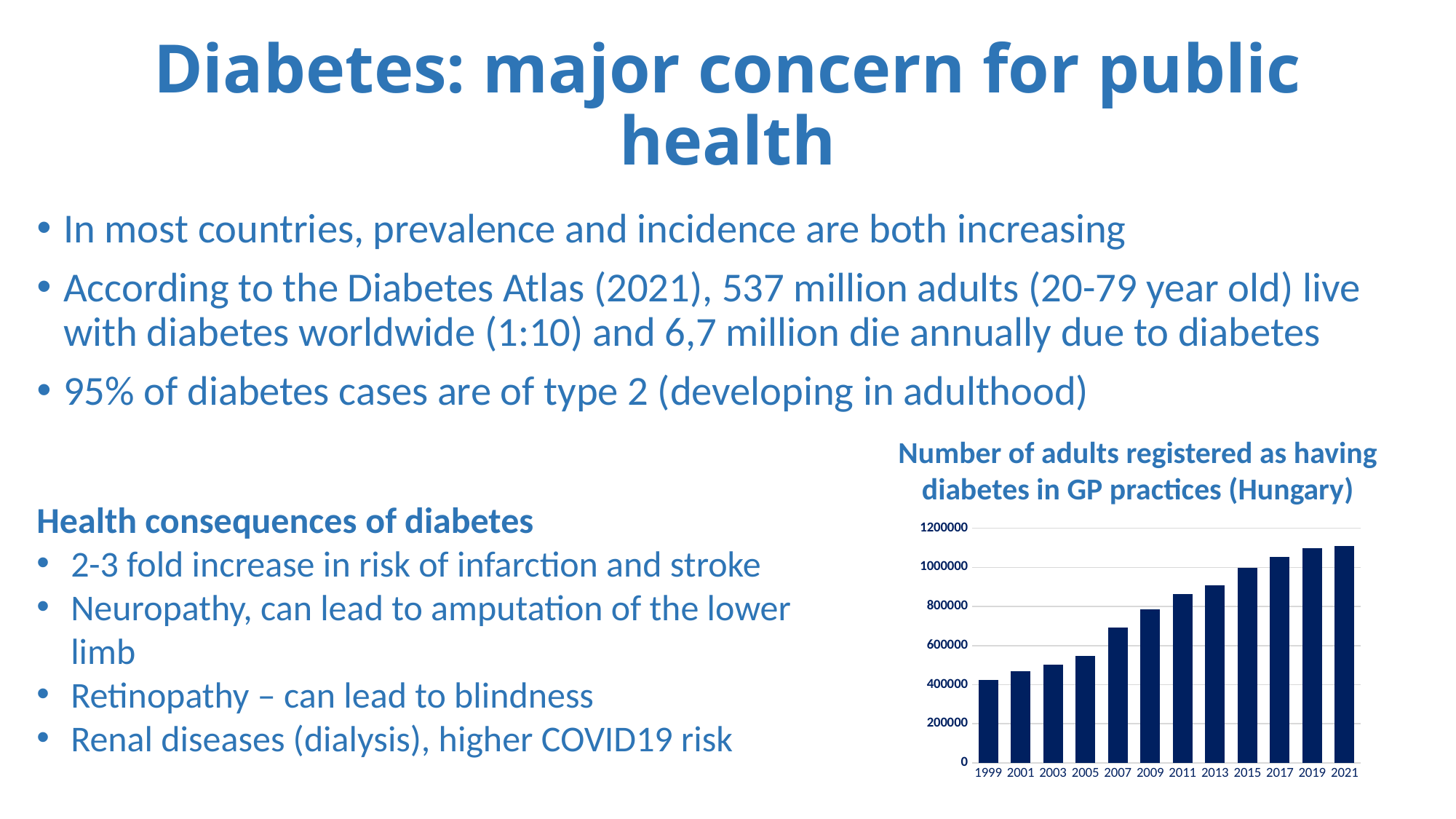
Is the value for 1999 greater or less than 600000? less Which year has the larger value, 2011 or 2003? 2011 Is the value for 2007 greater or less than 600000? greater Is the value for 2005 greater or less than 600000? less Which year has the larger value, 2005 or 2007? 2007 Do the values in the chart rise or fall from 1999 to 2021? rise What kind of chart is shown on the slide? bar chart Which year has the lowest number of adults registered as having diabetes? 1999 How many years (bars) are plotted in the chart? 12 What is the title of the chart? Number of adults registered as having diabetes in GP practices (Hungary)